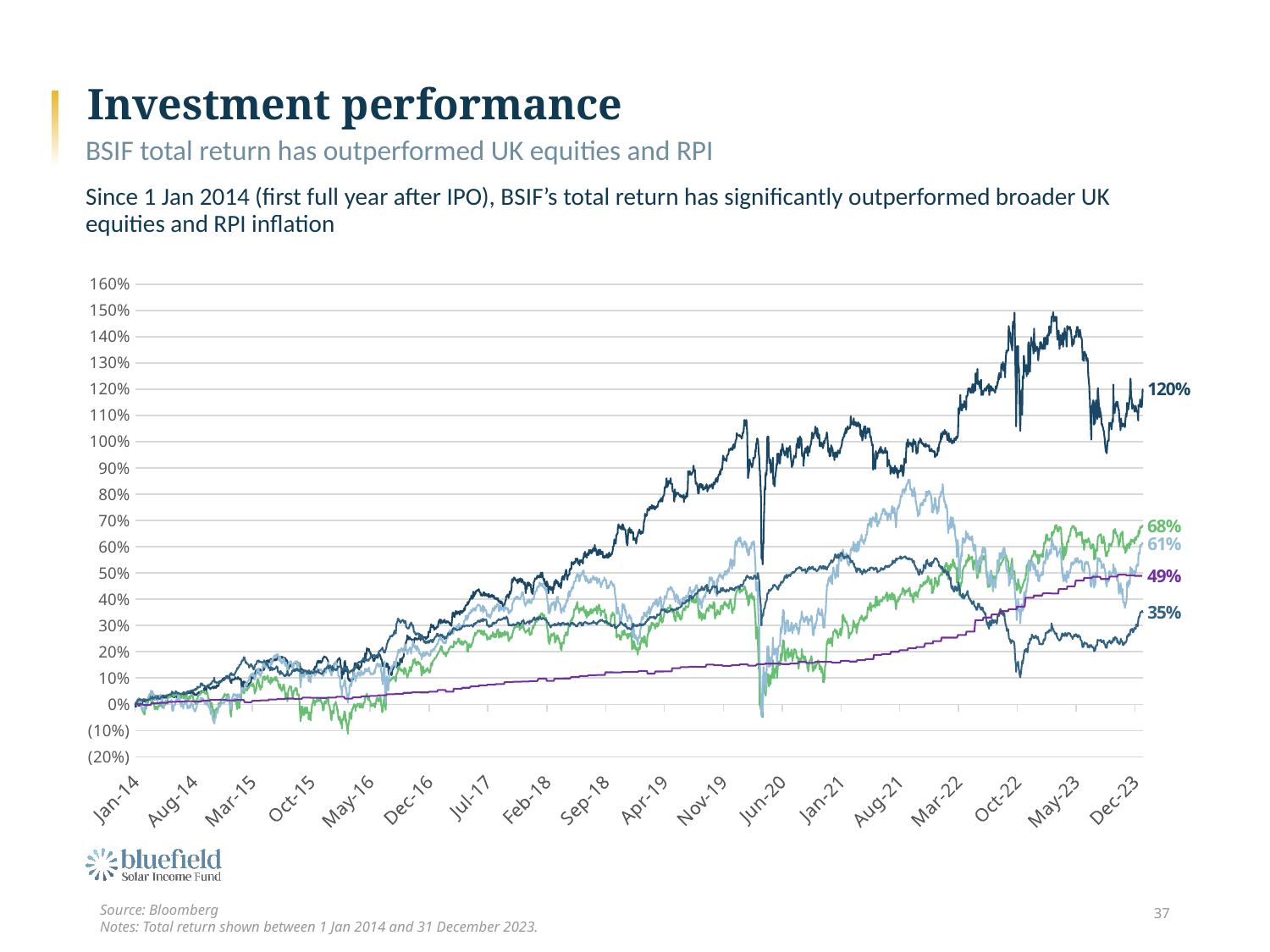
What is the lowest end-of-period value labelled on the chart? 35% What is the title of the slide containing the chart? Investment performance What is the first date label on the x axis? Jan-14 Which is larger, the end value labelled 61% or the end value labelled 49%? 61% What is the difference between the labelled end values 49% and 35%? 14% What is the difference between the labelled end values 68% and 61%? 7% How many end-of-period percentage labels are printed at the right edge of the chart? 5 Does the top (dark blue) line overall rise or fall from Jan-14 to Dec-23? rise What kind of chart is shown on the slide? line chart What is the highest end-of-period value labelled on the chart? 120% Is the peak of the top line during 2023 greater or less than 140%? greater What is the difference between the highest labelled end value (120%) and the second highest (68%)? 52%